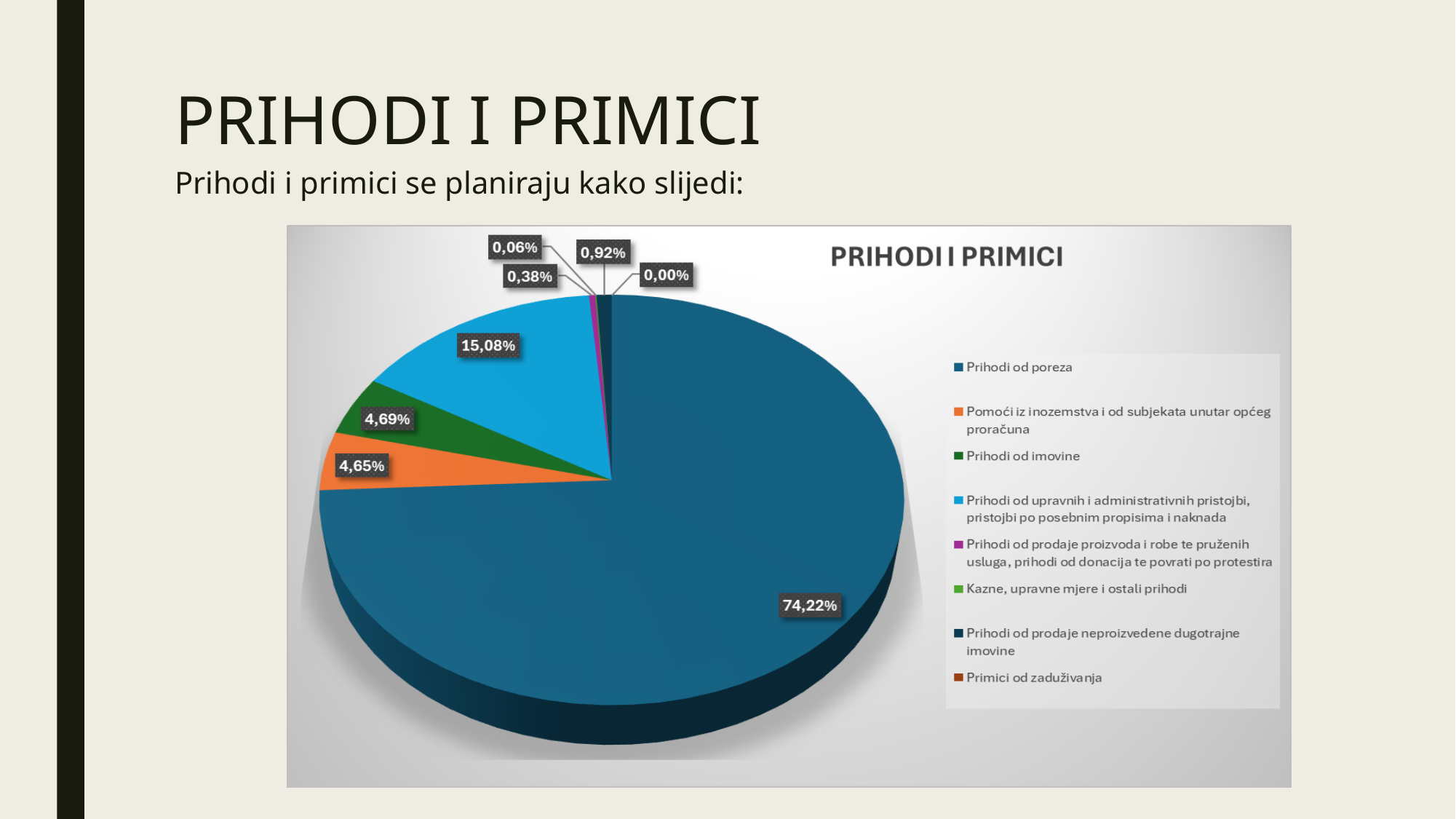
How many categories does the legend of the pie chart list? 8 What is the title of the chart? PRIHODI I PRIMICI What is the value shown for "Prihodi od upravnih i administrativnih pristojbi, pristojbi po posebnim propisima i naknada"? 15,08% What share of the pie does "Prihodi od poreza" represent? 74,22% What is the value shown for "Primici od zaduživanja"? 0,00% What kind of chart is shown on the slide? pie chart What is the difference between the shares of "Prihodi od poreza" and "Prihodi od upravnih i administrativnih pristojbi, pristojbi po posebnim propisima i naknada"? 59,14% Which category has the largest share of the pie? Prihodi od poreza What is the value shown for "Prihodi od imovine"? 4,69% Which category has the smallest share of the pie? Primici od zaduživanja Which is larger: the share of "Prihodi od prodaje neproizvedene dugotrajne imovine" or the share of "Kazne, upravne mjere i ostali prihodi"? Prihodi od prodaje neproizvedene dugotrajne imovine What is the value shown for "Pomoći iz inozemstva i od subjekata unutar općeg proračuna"? 4,65%